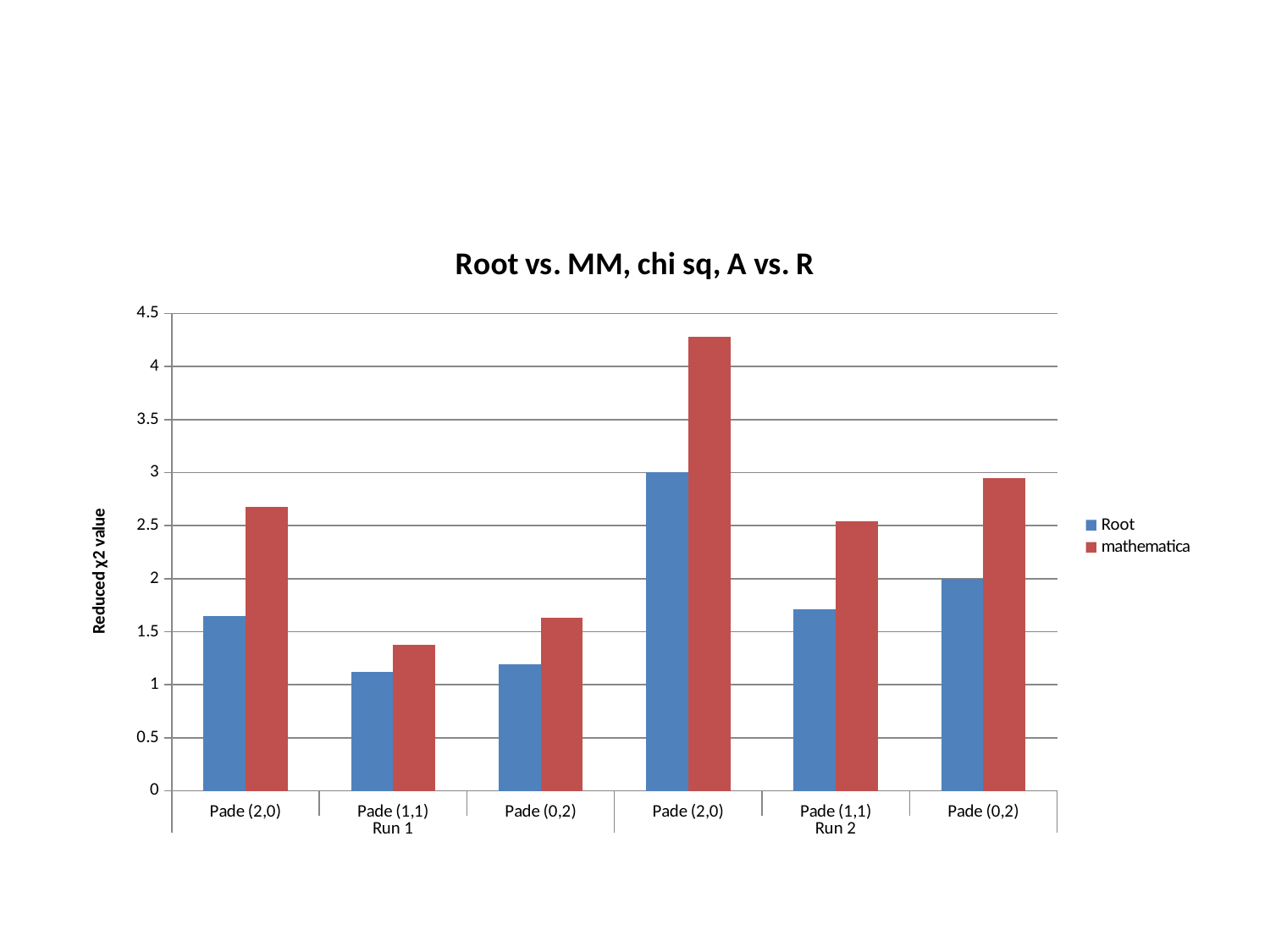
Is the mathematica value for Pade (2,0) in Run 2 greater or less than 4? greater What is the label on the vertical axis? Reduced χ2 value In Run 2, which has the larger Root value, Pade (1,1) or Pade (0,2)? Pade (0,2) How many category groups of bars are plotted along the x axis? 6 Which category has the lowest Root value? Pade (1,1) in Run 1 For Pade (2,0) in Run 1, which series has the larger value, Root or mathematica? mathematica How many series does the legend list? 2 Is the Root value for Pade (1,1) in Run 1 greater or less than 1.5? less What is the title of the chart? Root vs. MM, chi sq, A vs. R Is the mathematica value for Pade (0,2) in Run 1 greater or less than 1.5? greater Which category has the highest mathematica value? Pade (2,0) in Run 2 What kind of chart is shown on the slide? bar chart